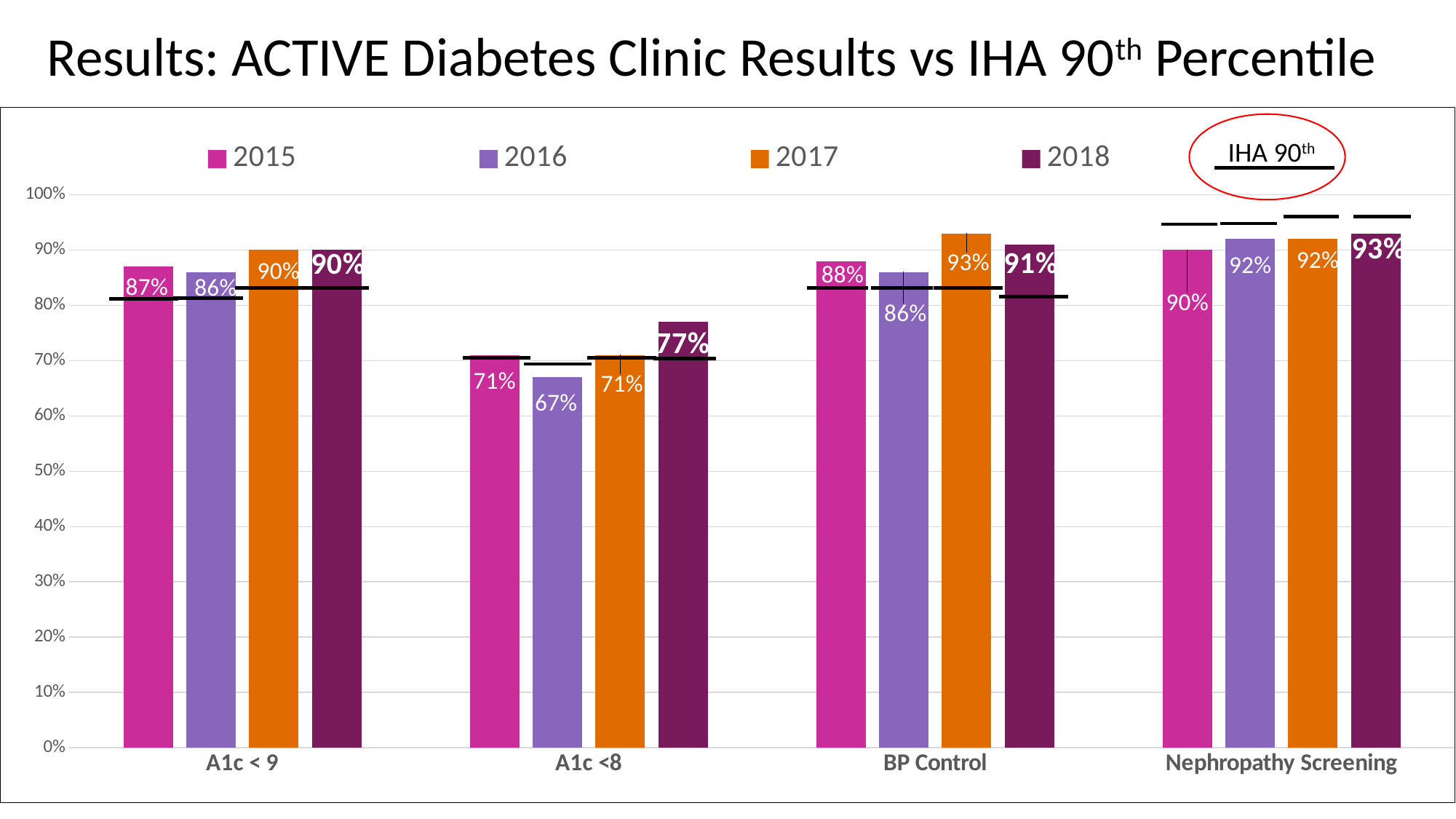
What is the 2015 value for A1c < 9? 87% How many year series (2015–2018) does the legend list? 4 What is the 2017 value for BP Control? 93% Which is larger, the 2017 value for BP Control or the 2018 value for BP Control? 2017 What kind of chart is shown on the slide? Bar chart Which year has the lowest value for BP Control? 2016 How many categories are shown on the x axis? 4 Which legend entry is circled in red? IHA 90th What is the 2016 value for A1c <8? 67% Which year has the highest value for A1c <8? 2018 What is the 2018 value for Nephropathy Screening? 93% What is the difference between the 2018 and 2016 values for A1c <8? 10%